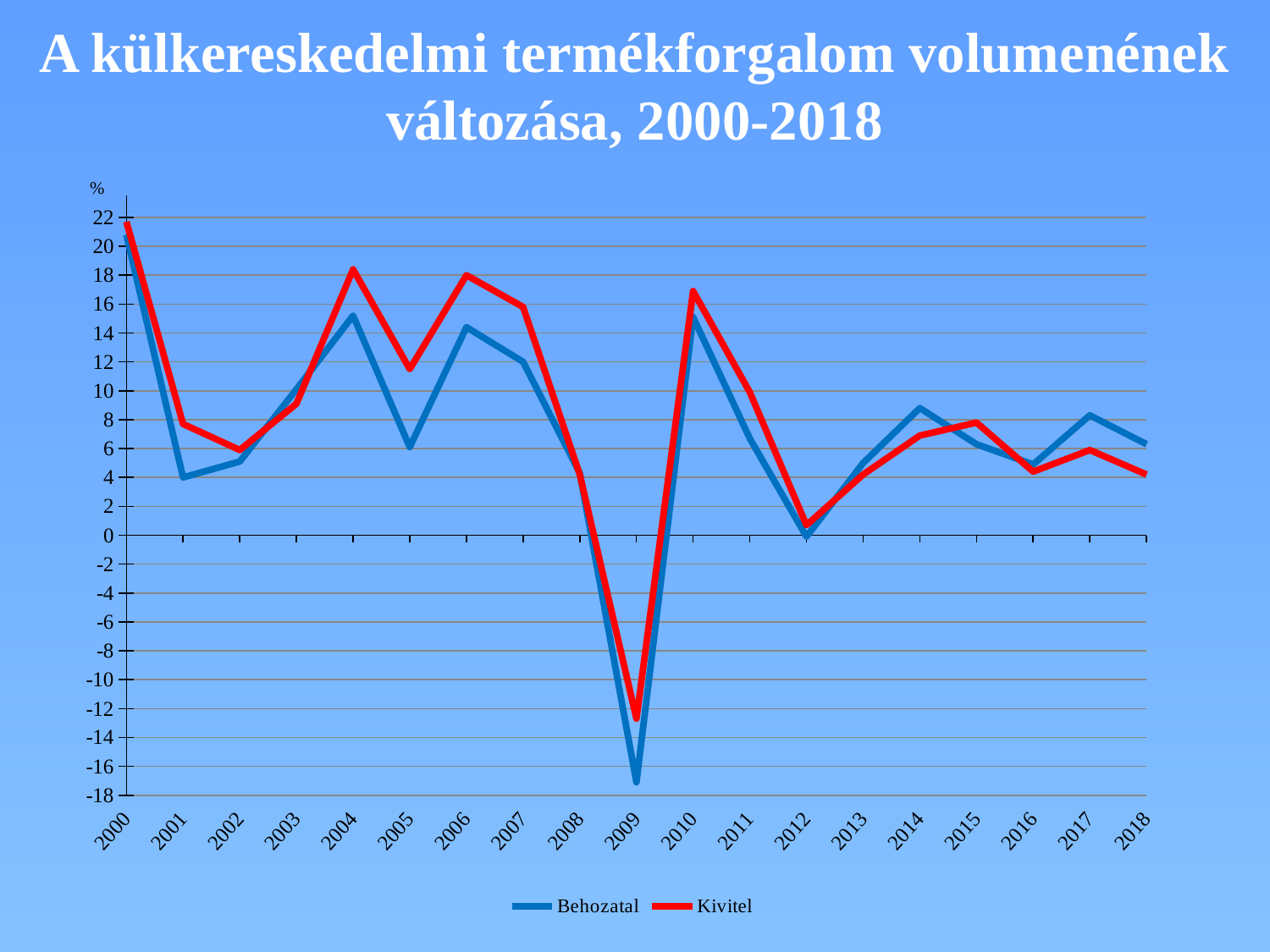
How many series does the legend list? 2 In which year does the Behozatal series reach its highest value? 2000 In which year does the Kivitel series reach its highest value? 2000 Is the Behozatal value for 2009 greater or less than -14? less In 2005, which series has the larger value, Behozatal or Kivitel? Kivitel In which year does the Behozatal series reach its lowest value? 2009 What kind of chart is shown on the slide? line chart In 2014, which series has the larger value, Behozatal or Kivitel? Behozatal What colour is the Kivitel line? red In which year does the Kivitel series reach its lowest value? 2009 How many years are plotted along the x axis? 19 Is the Kivitel value for 2004 greater or less than 16? greater